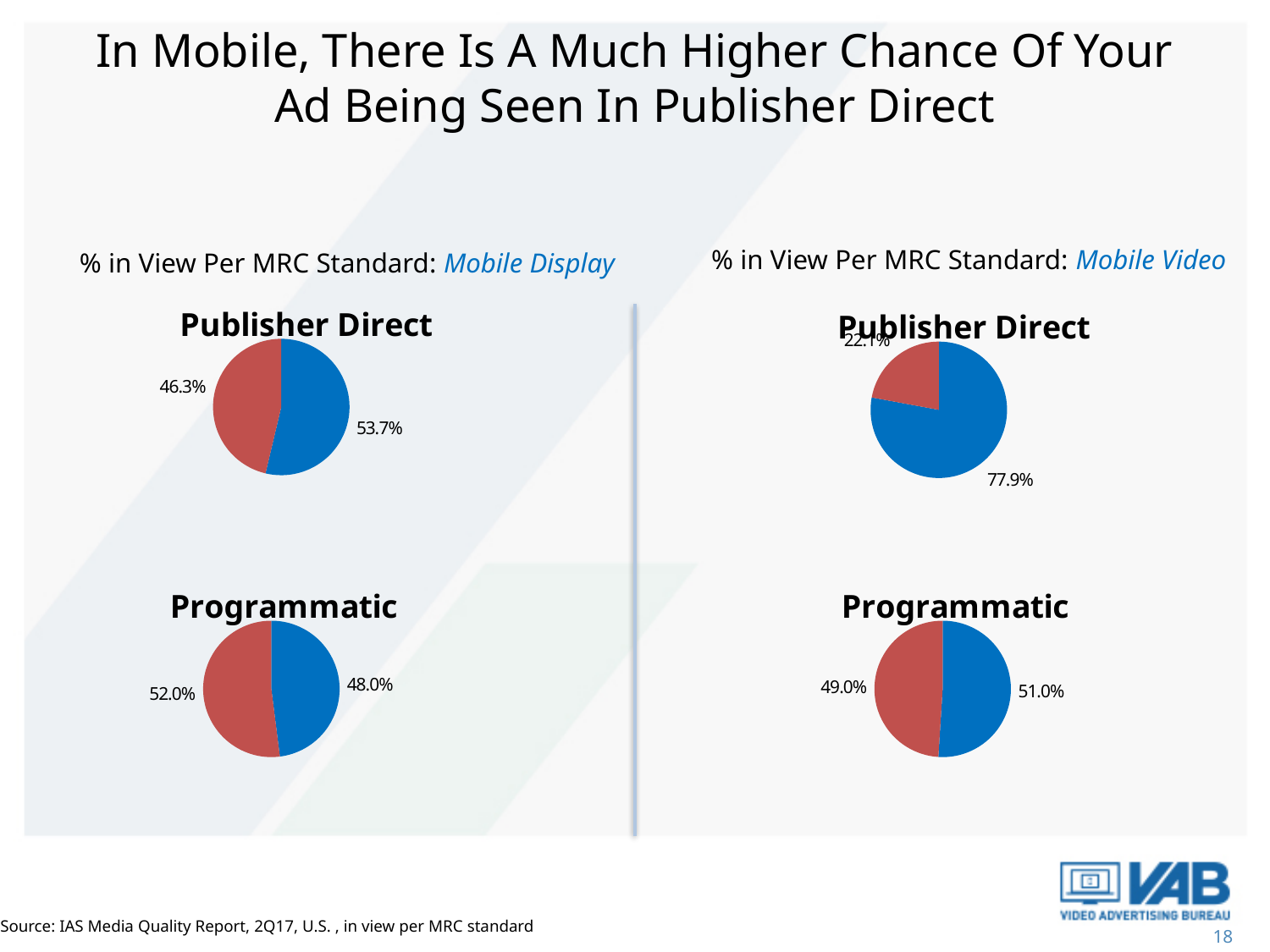
How many pie charts are shown on the slide? 4 In the Mobile Video Publisher Direct pie chart, what is the value of the blue slice? 77.9% In the Mobile Video Publisher Direct pie chart, what is the difference between the blue slice and the red slice? 55.8% What kind of chart is used for the Mobile Video Programmatic data? pie chart In the Mobile Display Publisher Direct pie chart, what is the value of the blue slice? 53.7% In the Mobile Video Programmatic pie chart, what is the value of the blue slice? 51.0% Which is larger: the blue slice in the Mobile Display Publisher Direct chart or the blue slice in the Mobile Video Publisher Direct chart? Mobile Video Publisher Direct How many slices does the Mobile Display Publisher Direct pie chart have? 2 In the Mobile Video Publisher Direct pie chart, what is the value of the red slice? 22.1% In the Mobile Display Programmatic pie chart, which slice is larger, the blue or the red? red In the Mobile Display Publisher Direct pie chart, what is the value of the red slice? 46.3% In the Mobile Display Programmatic pie chart, what is the value of the red slice? 52.0%